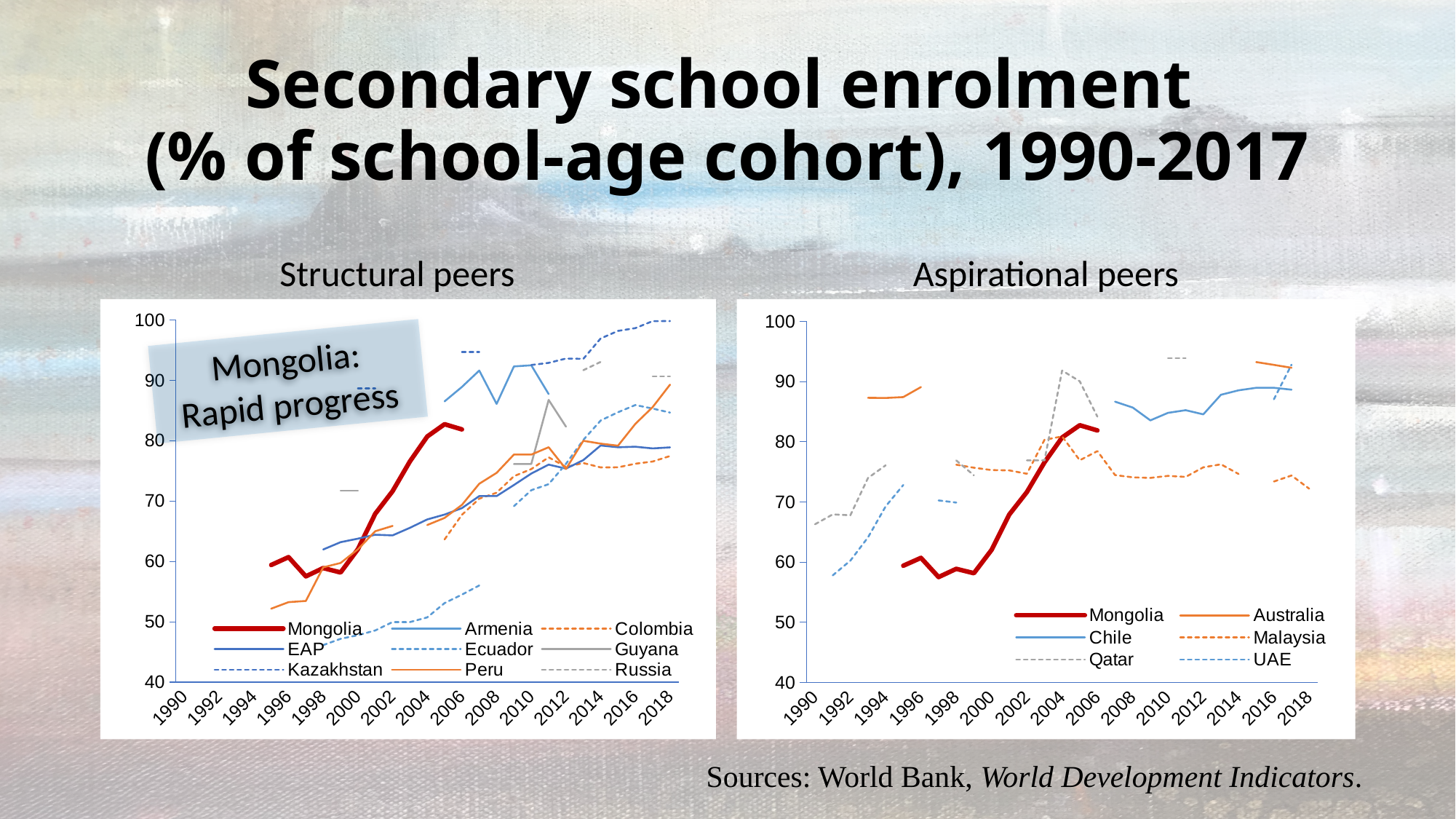
In the 'Structural peers' chart, is the value for Mongolia in 2005 greater or less than 70? greater What is the title of the slide above the two charts? Secondary school enrolment (% of school-age cohort), 1990-2017 In the 'Aspirational peers' chart, does the Mongolia line rise or fall between 1999 and 2005? rise In the 'Structural peers' chart, is the value for Ecuador in 1998 greater or less than 50? less How many series does the legend of the 'Structural peers' chart list? 9 In the 'Aspirational peers' chart, is the value for Malaysia in 2018 greater or less than 80? less How many series does the legend of the 'Aspirational peers' chart list? 6 In the 'Structural peers' chart, which series is drawn as a thick dark red line? Mongolia What kind of chart is the 'Structural peers' chart? line chart